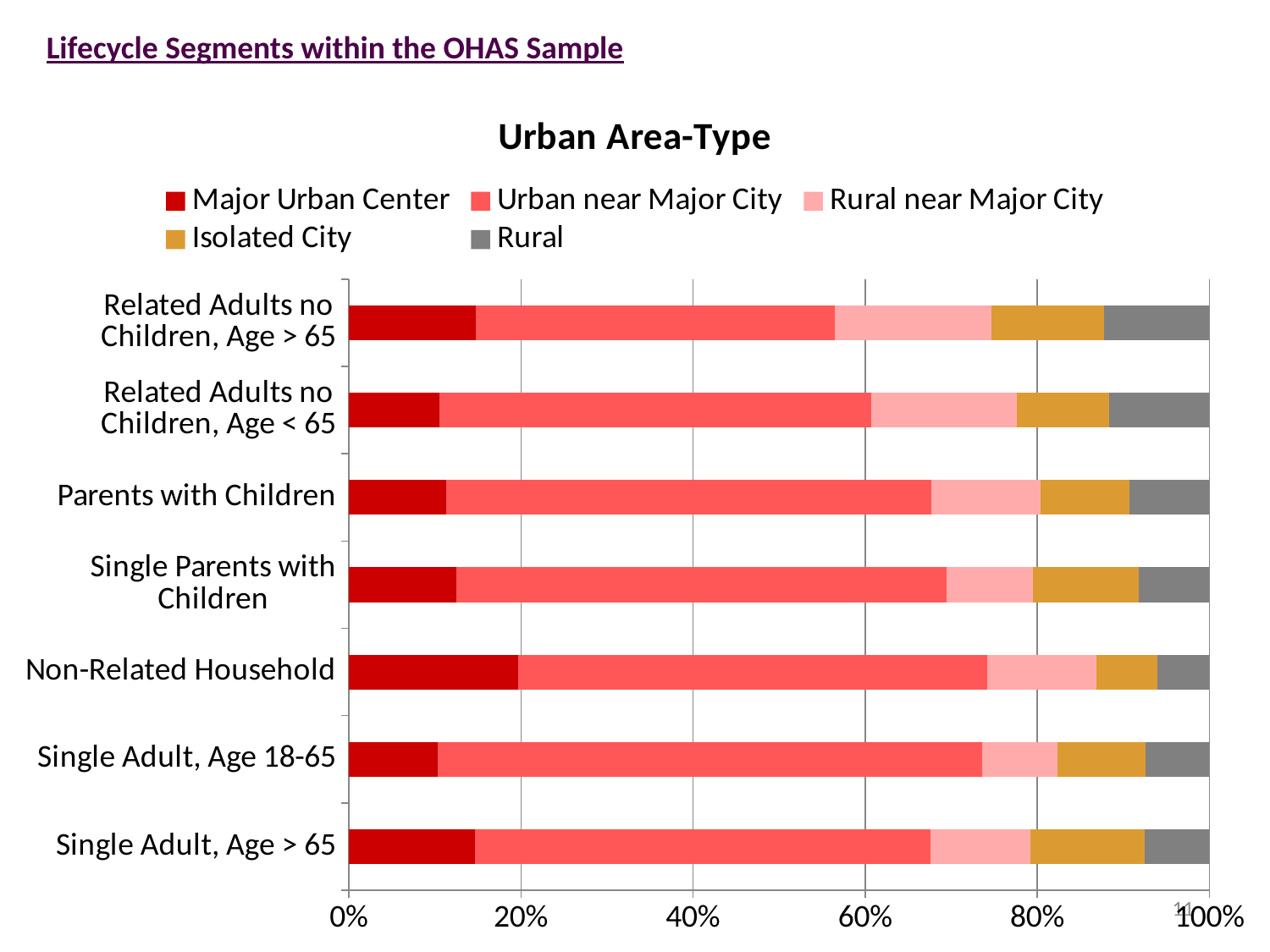
Is the Urban near Major City share for Non-Related Household greater or less than 40%? greater Which is larger, the Rural share for Related Adults no Children, Age > 65 or for Non-Related Household? Related Adults no Children, Age > 65 Which category has the largest Major Urban Center share? Non-Related Household What type of chart is shown on the slide? Stacked bar chart Which series is shown in grey in the legend? Rural What is the title of the chart? Urban Area-Type Which is larger, the Major Urban Center share for Non-Related Household or for Parents with Children? Non-Related Household How many lifecycle segment categories are plotted on the chart? 7 Is the Major Urban Center share for Related Adults no Children, Age > 65 greater or less than 20%? less How many series does the legend list? 5 What is the total of the stacked bar for Parents with Children? 100% Is the Major Urban Center share for Single Adult, Age 18-65 greater or less than 20%? less